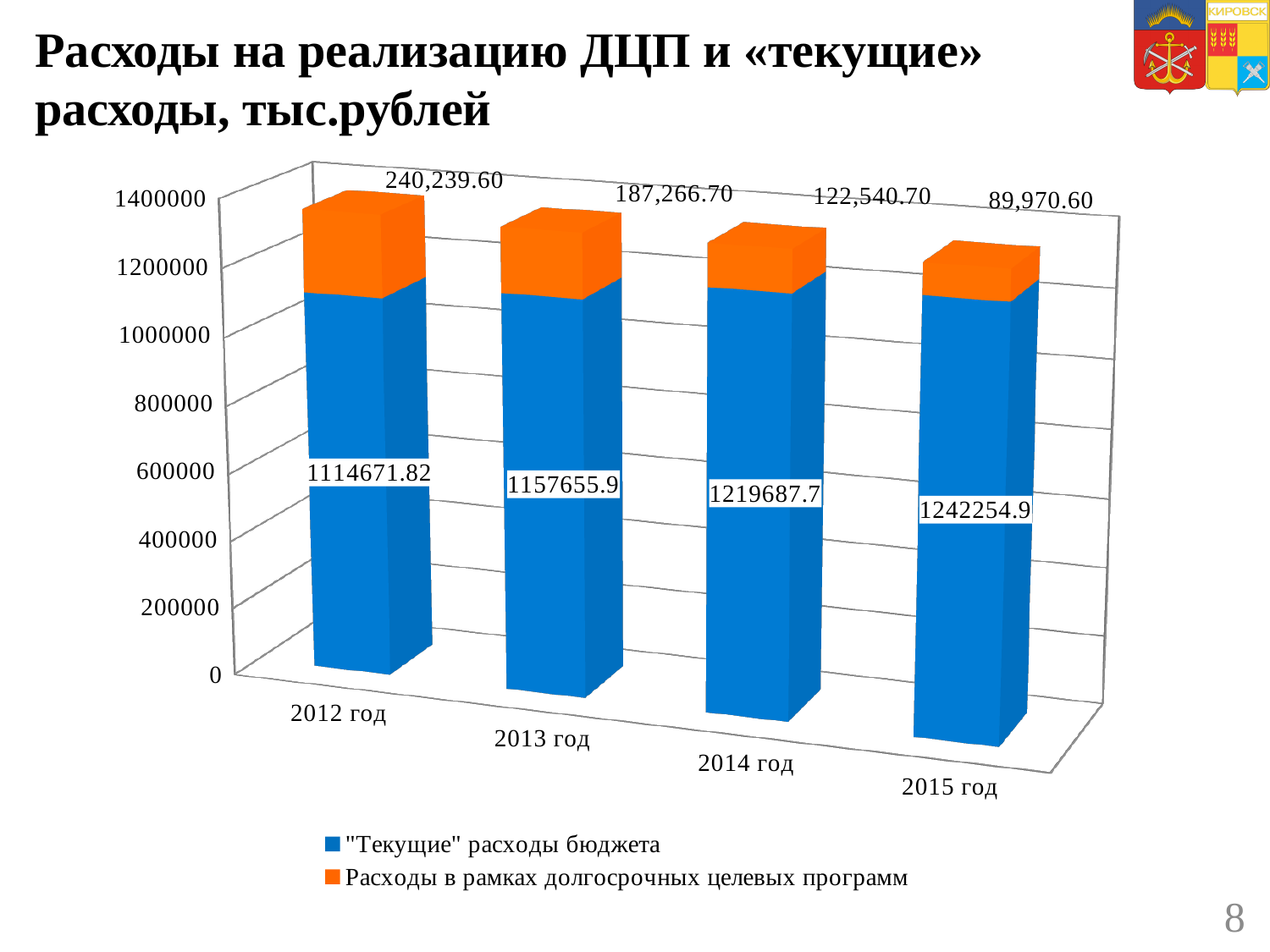
How many years are shown on the x axis? 4 How many series does the legend list? 2 Do the values for Расходы в рамках долгосрочных целевых программ rise or fall from 2012 год to 2015 год? Fall What kind of chart is shown on the slide? Stacked bar chart What is the value of Расходы в рамках долгосрочных целевых программ for 2013 год? 187,266.70 Which is larger: "Текущие" расходы бюджета for 2013 год or for 2014 год? 2014 год What is the total of the stacked bar for 2014 год? 1342228.4 What is the value of Расходы в рамках долгосрочных целевых программ for 2015 год? 89,970.60 What is the difference between the Расходы в рамках долгосрочных целевых программ values for 2012 год and 2015 год? 150,269.00 What is the value of "Текущие" расходы бюджета for 2012 год? 1114671.82 Which year has the lowest value for Расходы в рамках долгосрочных целевых программ? 2015 год Which year has the highest value for "Текущие" расходы бюджета? 2015 год